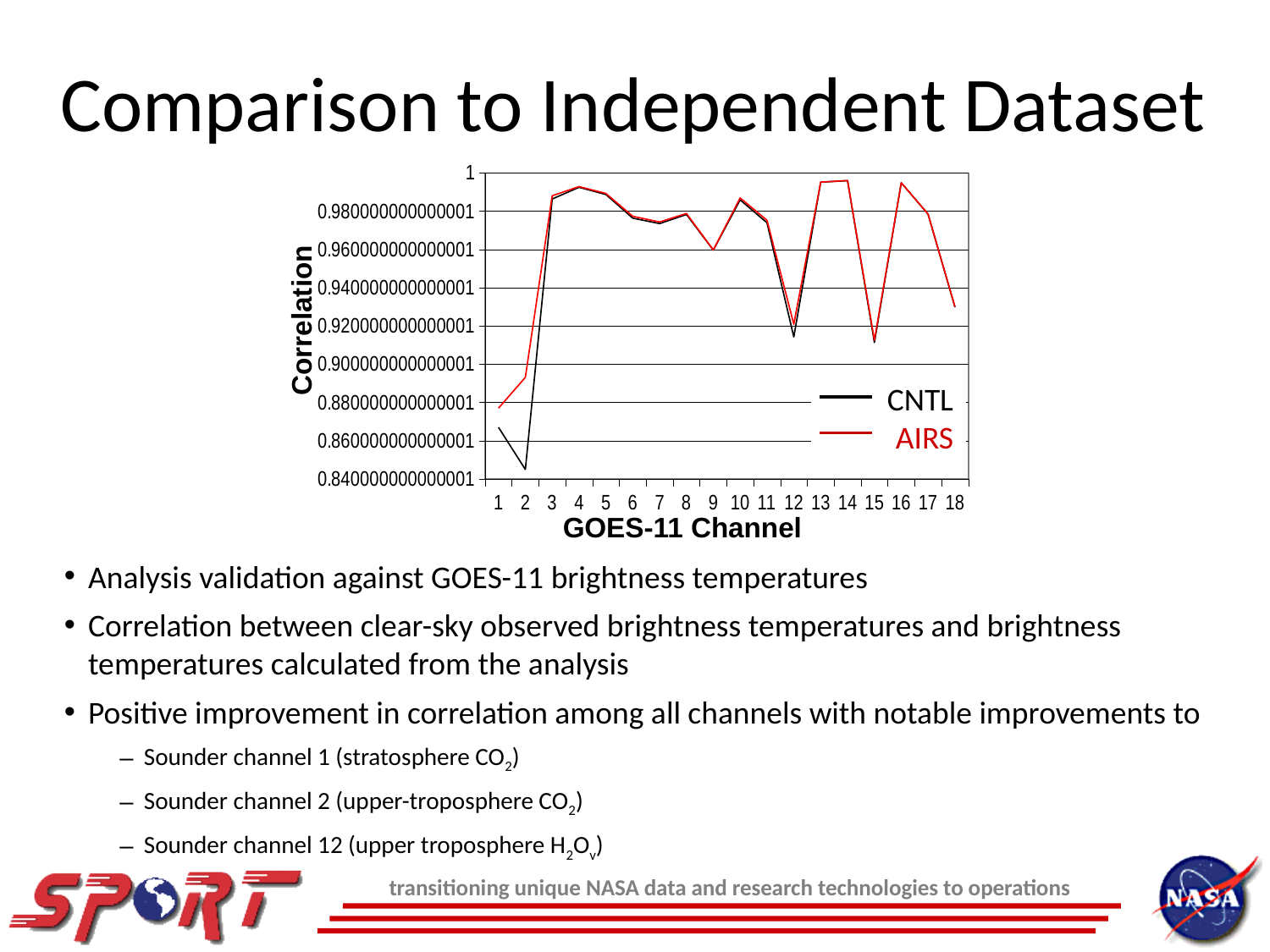
Which GOES-11 channel has the lowest CNTL correlation? 2 How many GOES-11 channels are plotted along the x axis? 18 What is the label of the x axis? GOES-11 Channel Is the CNTL correlation for channel 2 greater or less than 0.86? less Is the AIRS correlation for channel 18 greater or less than 0.94? less What kind of chart is shown on the slide? line chart Which GOES-11 channel has the lowest AIRS correlation? 1 Is the AIRS correlation for channel 13 greater or less than 0.98? greater Does the AIRS correlation rise or fall from channel 16 to channel 18? fall How many series does the legend list? 2 At channel 2, which series has the higher correlation, CNTL or AIRS? AIRS